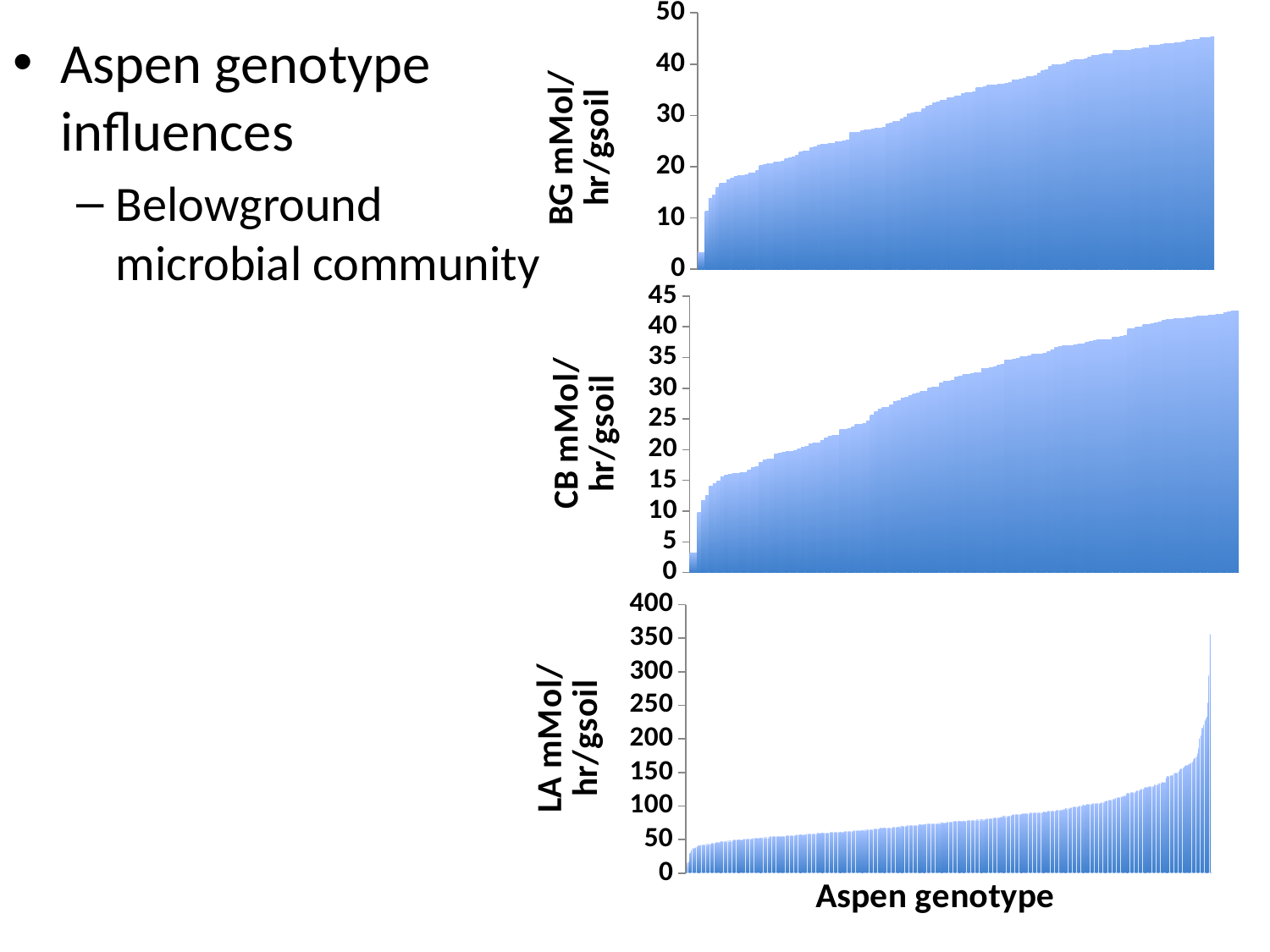
What is the highest tick value shown on the y axis of the bottom chart (LA mMol/hr/gsoil)? 400 In the top chart (BG mMol/hr/gsoil), is the value of the tallest bar greater or less than 40? greater What kind of chart is the top chart (BG mMol/hr/gsoil)? bar chart In the middle chart (CB mMol/hr/gsoil), is the value of the tallest bar greater or less than 40? greater In the bottom chart (LA mMol/hr/gsoil), do the bar values rise or fall from left to right along the x axis? rise What kind of chart is the bottom chart (LA mMol/hr/gsoil)? bar chart In the bottom chart (LA mMol/hr/gsoil), is the value of the leftmost bar greater or less than 50? less In the middle chart (CB mMol/hr/gsoil), do the bar values rise or fall from left to right along the x axis? rise In the top chart (BG mMol/hr/gsoil), do the bar values rise or fall from left to right along the x axis? rise What is the x-axis title shown under the bottom chart? Aspen genotype